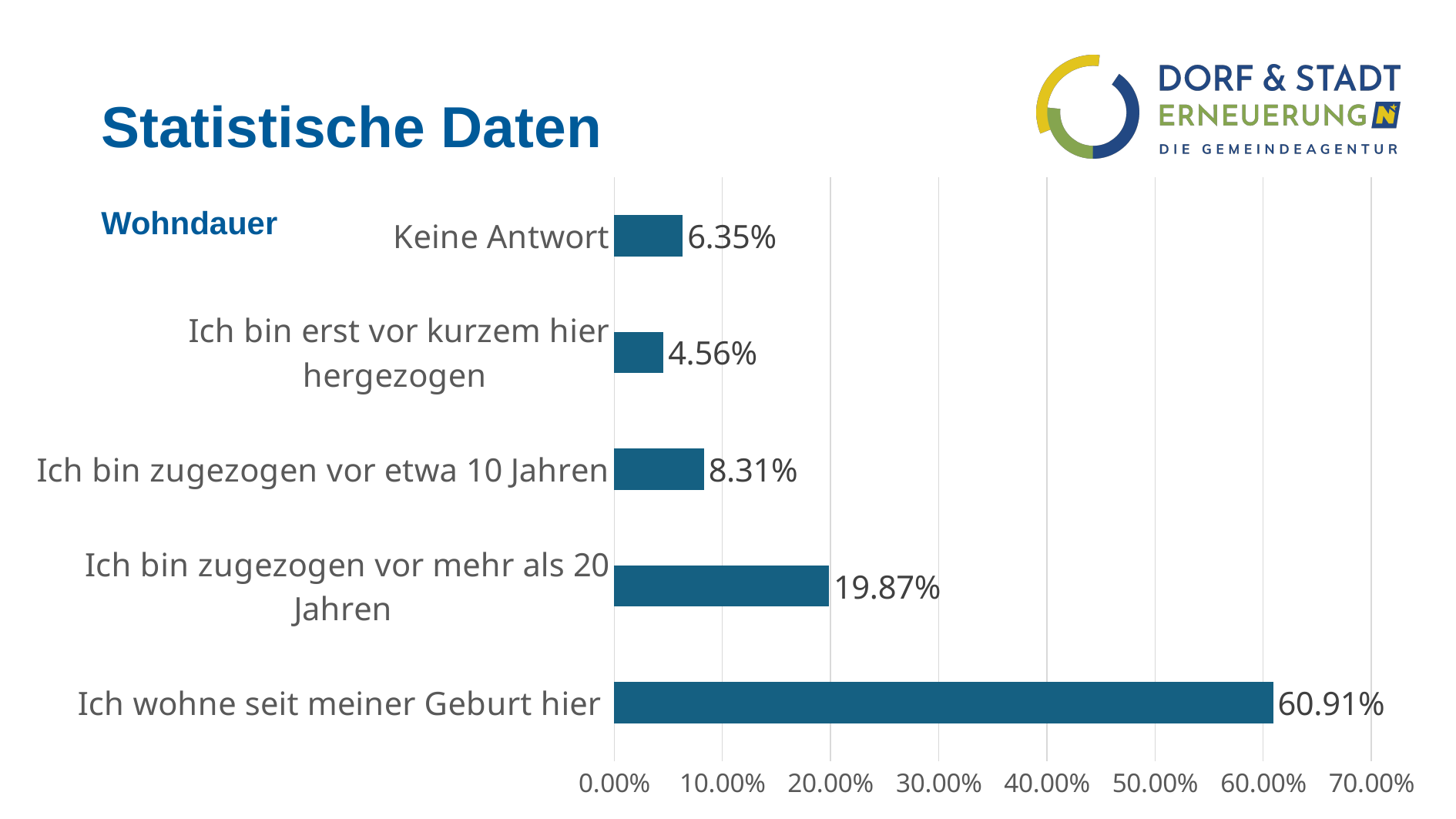
What is the value for "Keine Antwort"? 6.35% Which category has the lowest value? Ich bin erst vor kurzem hier hergezogen What is the value for "Ich wohne seit meiner Geburt hier"? 60.91% Which is larger: "Ich bin zugezogen vor etwa 10 Jahren" or "Keine Antwort"? Ich bin zugezogen vor etwa 10 Jahren What kind of chart is shown on the slide? bar chart Is the value for "Ich wohne seit meiner Geburt hier" greater or less than 50.00%? greater What is the label shown above the chart, next to the slide title? Wohndauer How many categories are shown in the chart? 5 What is the value for "Ich bin erst vor kurzem hier hergezogen"? 4.56% What is the value for "Ich bin zugezogen vor mehr als 20 Jahren"? 19.87% What is the difference between "Ich wohne seit meiner Geburt hier" and "Ich bin zugezogen vor mehr als 20 Jahren"? 41.04% Which category has the highest value? Ich wohne seit meiner Geburt hier